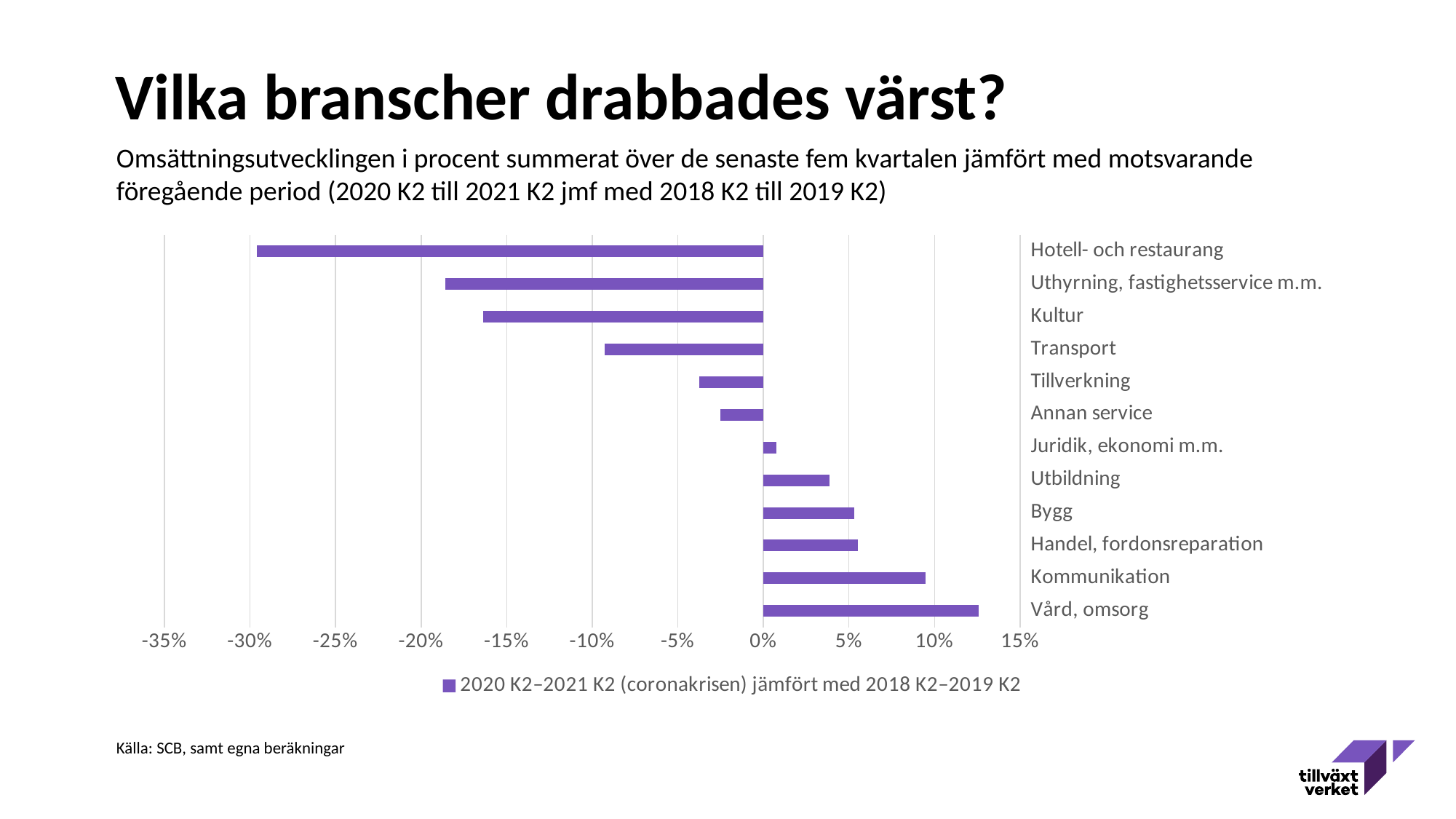
Is the value for Hotell- och restaurang greater or less than -25%? less Which category has the highest (most positive) value in the chart? Vård, omsorg Which has the larger value, Kommunikation or Bygg? Kommunikation Is the value for Kommunikation greater or less than 10%? less Is the value for Vård, omsorg greater or less than 10%? greater What kind of chart is shown on the slide? bar chart What is the legend entry for the plotted series? 2020 K2–2021 K2 (coronakrisen) jämfört med 2018 K2–2019 K2 Which category has the lowest (most negative) value in the chart? Hotell- och restaurang How many industry categories are plotted in the chart? 12 Which has the larger value, Kultur or Hotell- och restaurang? Kultur How many series does the chart legend list? 1